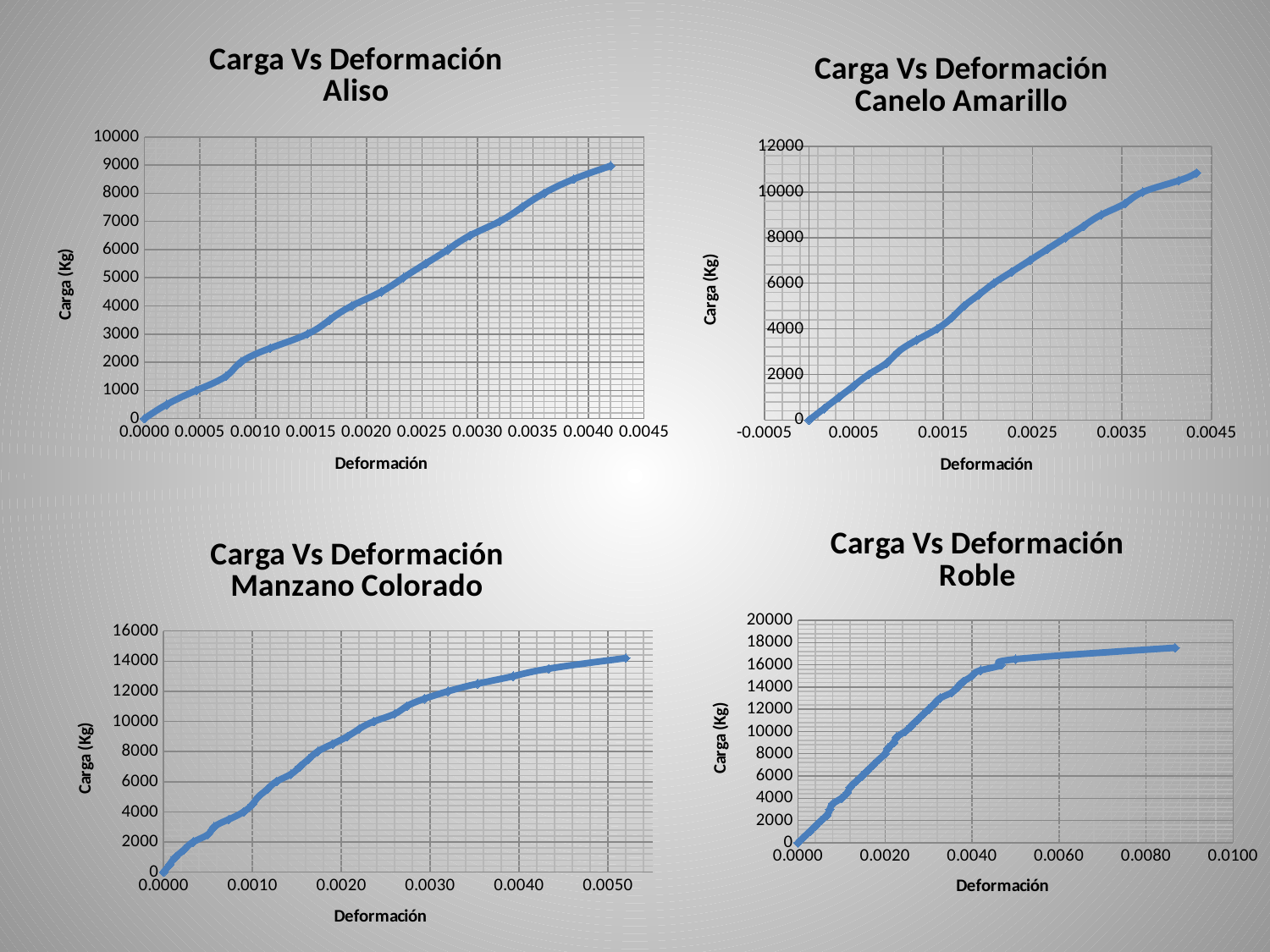
What kind of chart is the "Carga Vs Deformación Aliso" chart? line chart In the "Carga Vs Deformación Canelo Amarillo" chart, is the Carga at Deformación 0.0025 greater or less than 6000? greater What is the y-axis label of the "Carga Vs Deformación Roble" chart? Carga (Kg) In the "Carga Vs Deformación Aliso" chart, do the values rise or fall as Deformación increases? rise In the "Carga Vs Deformación Roble" chart, do the values rise or fall as Deformación increases? rise In the "Carga Vs Deformación Roble" chart, is the Carga at Deformación 0.0020 greater or less than 6000? greater In the "Carga Vs Deformación Canelo Amarillo" chart, is the Carga at Deformación 0.0015 greater or less than 5000? less How many charts are shown on the slide? 4